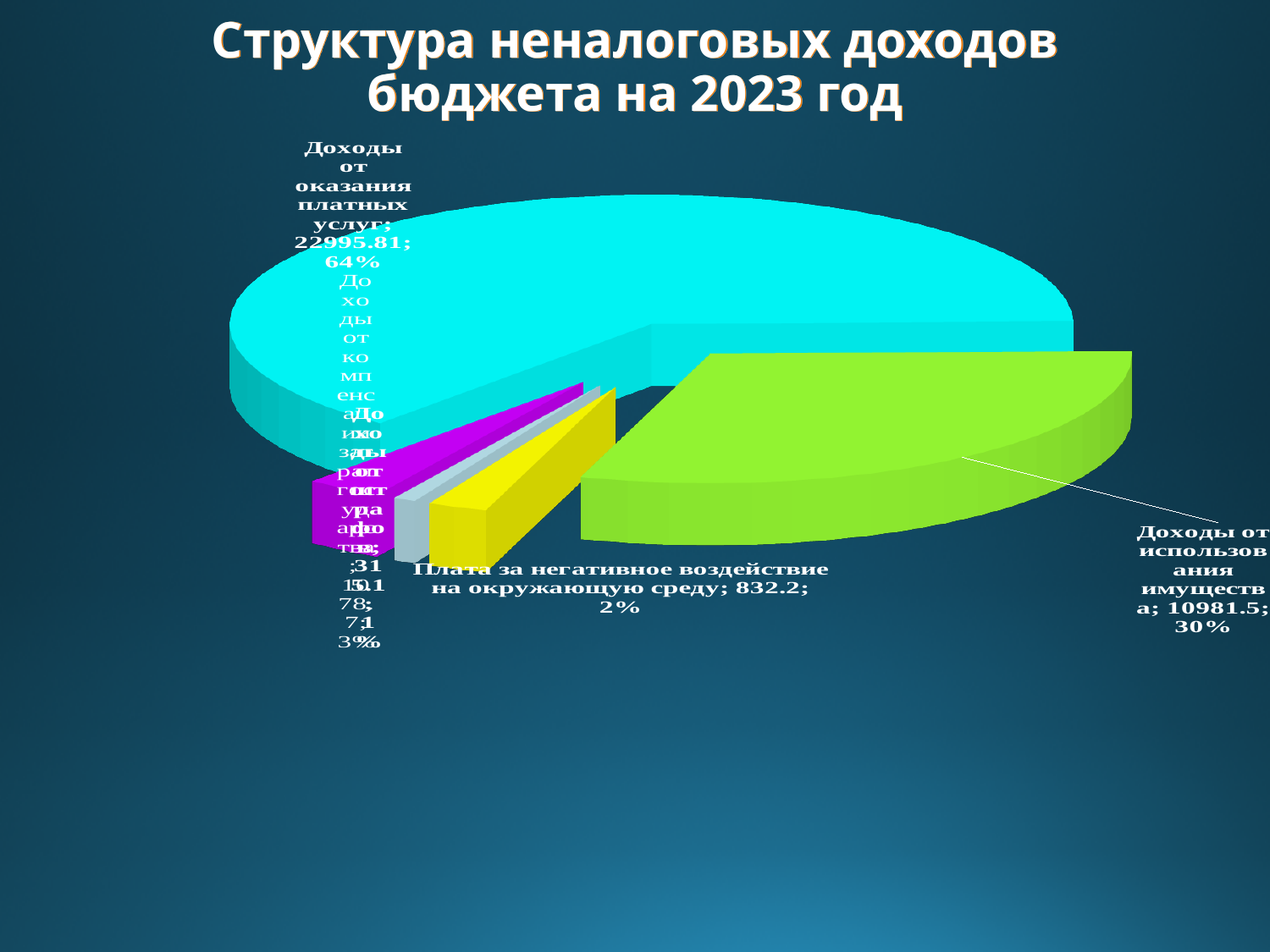
What share of the pie does Доходы от использования имущества represent? 30% What is the value shown for Плата за негативное воздействие на окружающую среду? 832.2 What share of the pie does Плата за негативное воздействие на окружающую среду represent? 2% Which is larger: Доходы от оказания платных услуг or Доходы от использования имущества? Доходы от оказания платных услуг What share of the pie does Доходы от оказания платных услуг represent? 64% What is the value shown for Доходы от оказания платных услуг? 22995.81 What is the title of the chart? Структура неналоговых доходов бюджета на 2023 год What kind of chart is shown on the slide? pie chart Which category has the largest slice of the pie? Доходы от оказания платных услуг What is the value shown for Доходы от использования имущества? 10981.5 What is the difference between the values for Доходы от оказания платных услуг and Доходы от использования имущества? 12014.31 How many slices does the pie chart have? 5